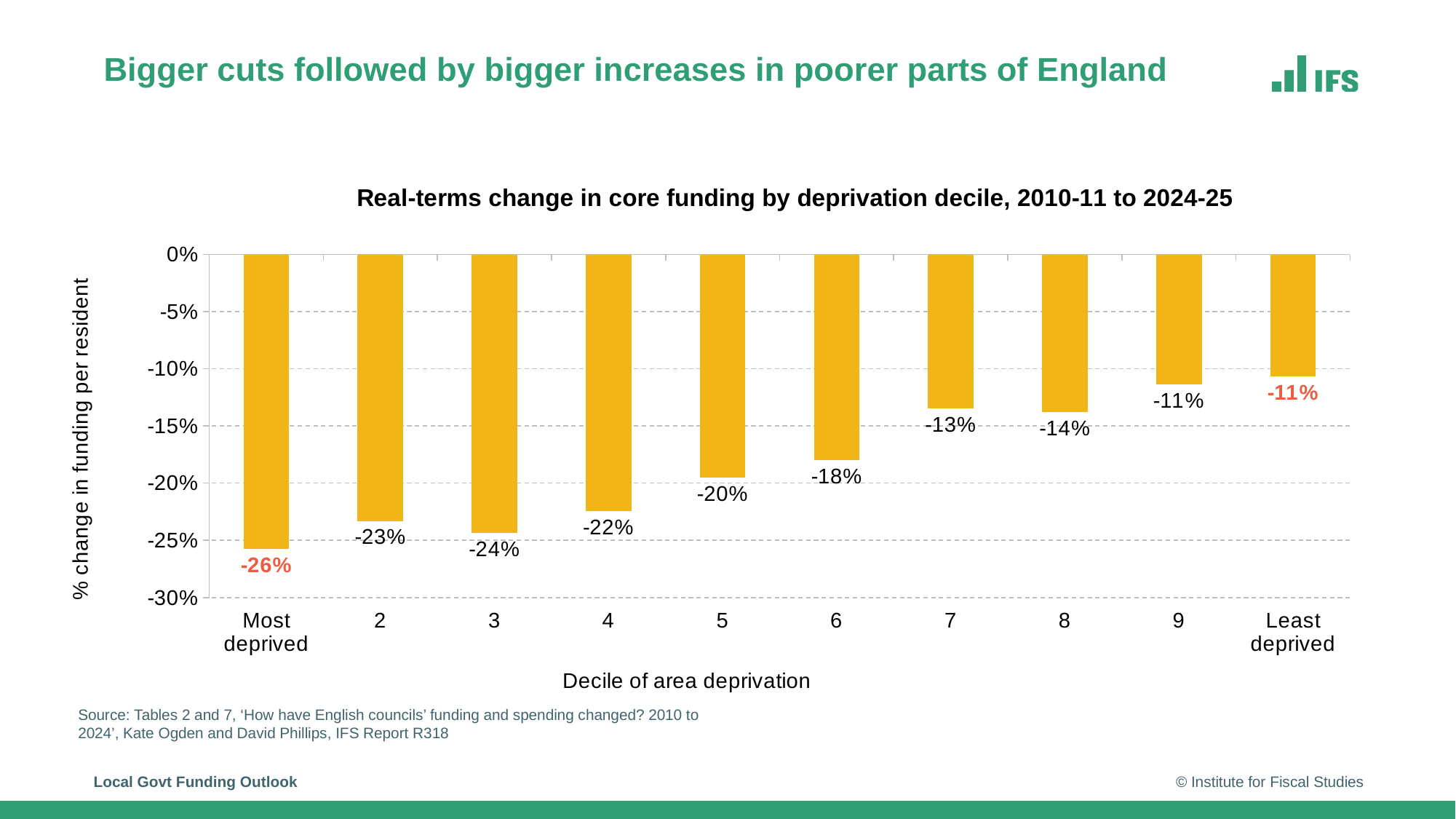
What is the real-terms change in core funding per resident for the most deprived decile? -26% What is the value shown for the least deprived decile? -11% What is the value shown for decile 3? -24% What is the difference in percentage points between the most deprived decile (-26%) and the least deprived decile (-11%)? 15 percentage points How many deprivation deciles are plotted on the chart? 10 What is the value shown for decile 6? -18% Which has the larger (less negative) value, decile 7 or decile 8? Decile 7 Moving from the most deprived to the least deprived decile, do the values generally rise or fall? Rise What kind of chart is shown on the slide? Bar chart What is the title of the chart? Real-terms change in core funding by deprivation decile, 2010-11 to 2024-25 Which deprivation decile shows the largest cut in funding per resident? Most deprived What is the difference in percentage points between decile 3 (-24%) and decile 4 (-22%)? 2 percentage points